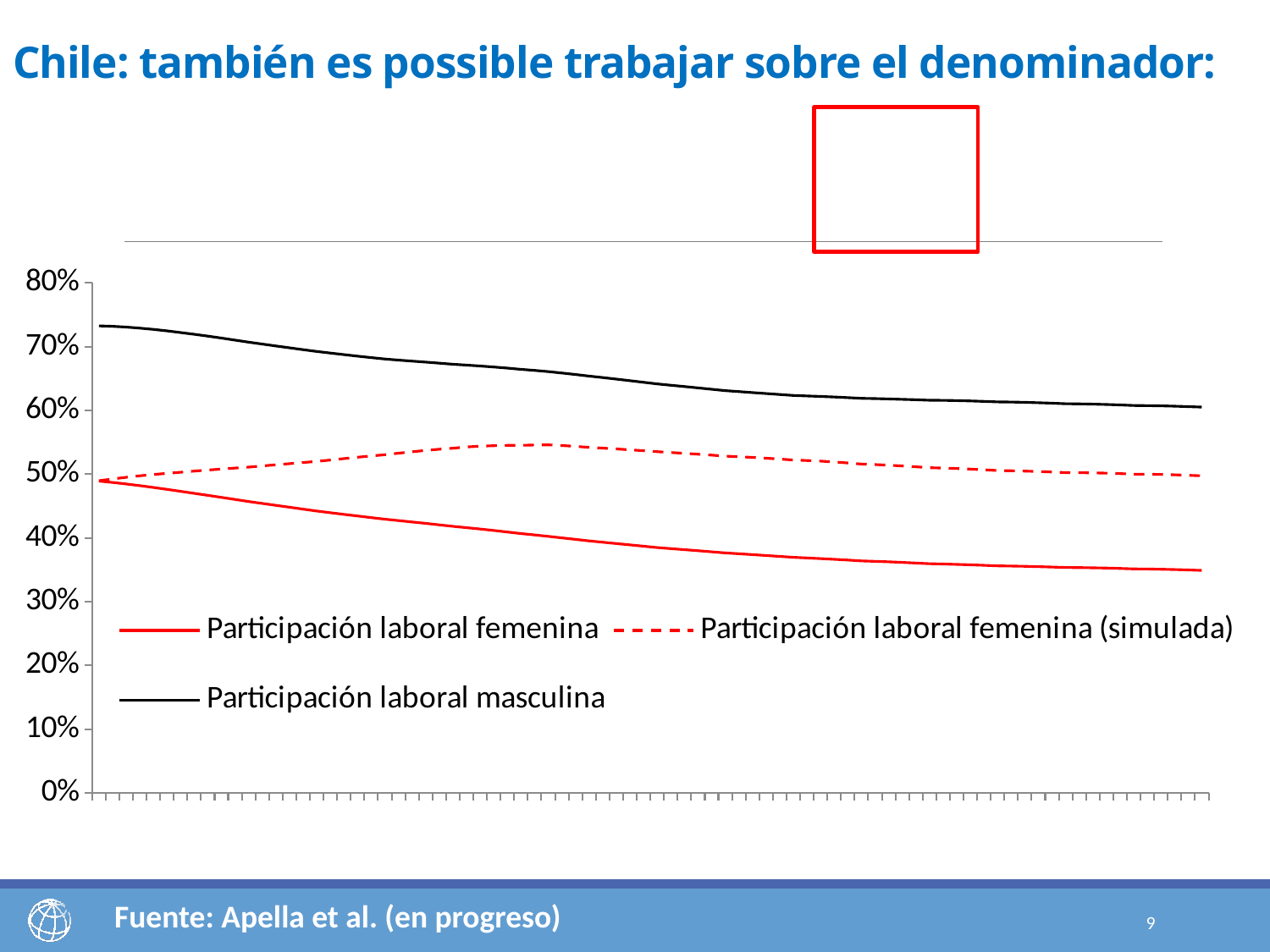
Is the value for Participación laboral femenina at the end of the series greater or less than 40%? less Which series is drawn with a dashed line? Participación laboral femenina (simulada) Which series has the lowest values at the right end of the chart? Participación laboral femenina Does the Participación laboral masculina series rise or fall along the x axis? fall What kind of chart is shown on the slide? line chart At the right end of the chart, which is larger: Participación laboral femenina (simulada) or Participación laboral femenina? Participación laboral femenina (simulada) Which series has the highest values throughout the chart? Participación laboral masculina Is the peak value of Participación laboral femenina (simulada) greater or less than 50%? greater Is the value for Participación laboral masculina at the start of the series greater or less than 70%? greater What colour is the line for Participación laboral masculina? black How many series does the legend list? 3 Does the Participación laboral femenina series rise or fall along the x axis? fall